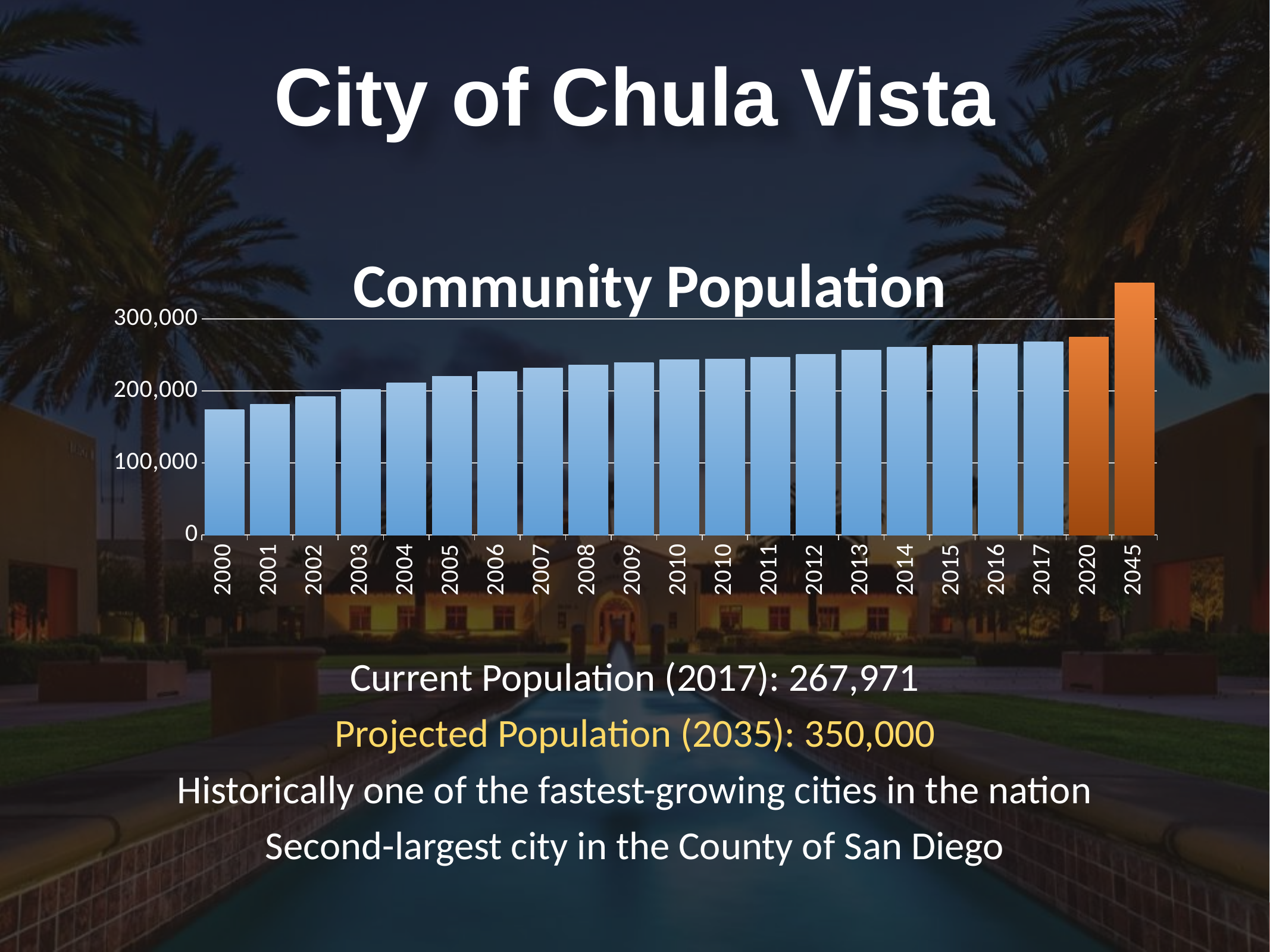
Which is larger, the bar for 2017 or the bar for 2045? 2045 Is the value for 2005 greater or less than 200,000? greater Which year has the lowest population bar in the chart? 2000 Which year has the highest population bar in the chart? 2045 Is the value for 2045 greater or less than 300,000? greater Is the value for 2000 greater or less than 200,000? less What kind of chart is shown on the slide? bar chart What is the title of the chart? Community Population Do the population values generally rise or fall from 2000 to 2045? rise How many bars in the chart are coloured orange rather than blue? 2 How many bars are plotted in the chart? 21